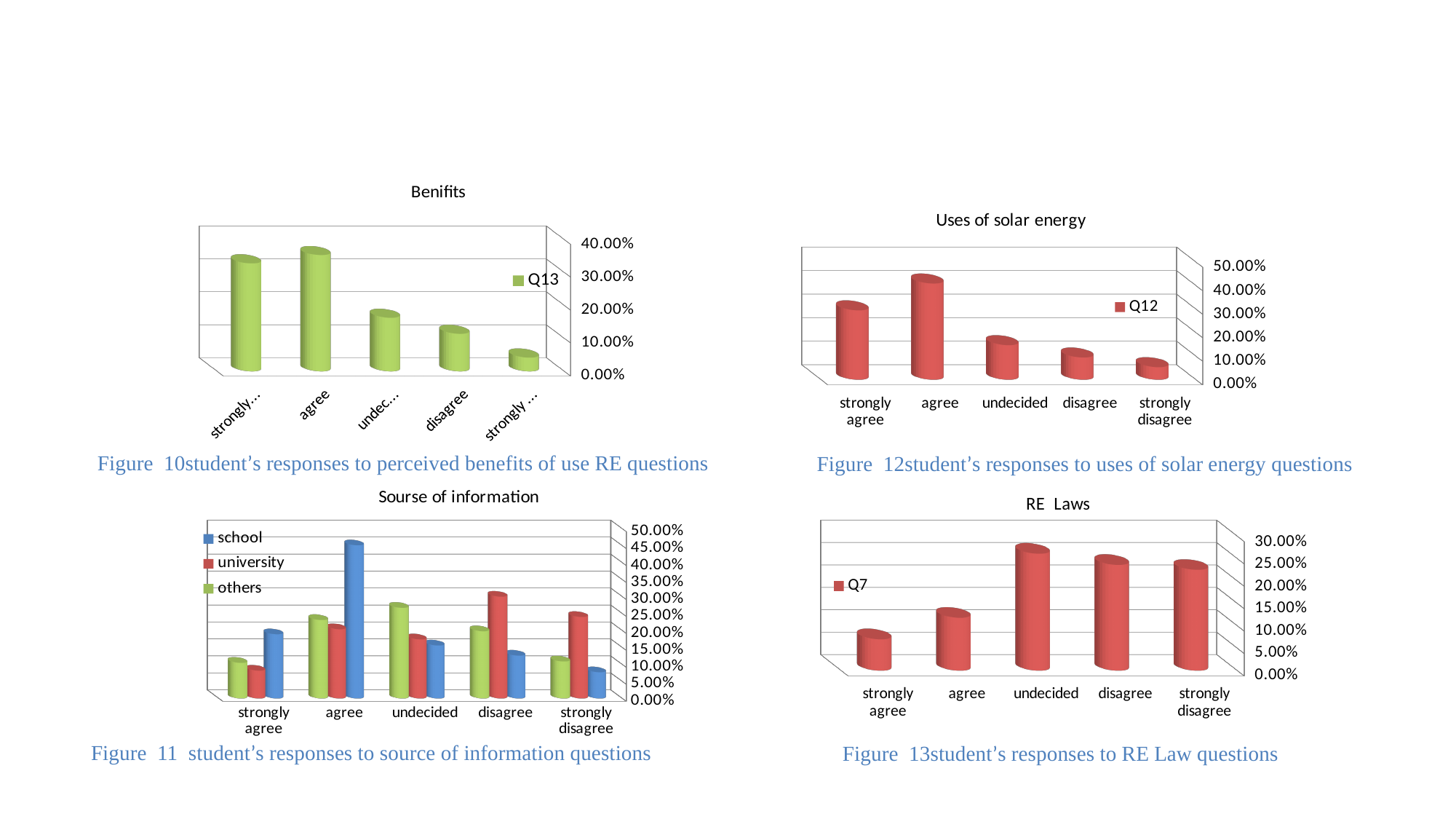
In the 'Sourse of information' chart, which series has the highest value for 'agree'? school In the 'Benifits' chart, how many categories are shown on the x axis? 5 How many series does the legend of the 'Sourse of information' chart list? 3 In the 'Uses of solar energy' chart, which category has the lowest value? strongly disagree In the 'Benifits' chart, is the value for 'agree' greater or less than 30.00%? greater In the 'RE Laws' chart, which category has the highest value? undecided In the 'Uses of solar energy' chart, is the value for 'undecided' greater or less than 20.00%? less In the 'Uses of solar energy' chart, which series name is shown in the legend? Q12 In the 'Benifits' chart, which category has the lowest value? strongly disagree In the 'Sourse of information' chart, is the value of 'university' for 'disagree' larger than the value of 'school' for 'disagree'? Yes What kind of chart is the 'RE Laws' chart? bar chart In the 'Uses of solar energy' chart, which category has the highest value? agree